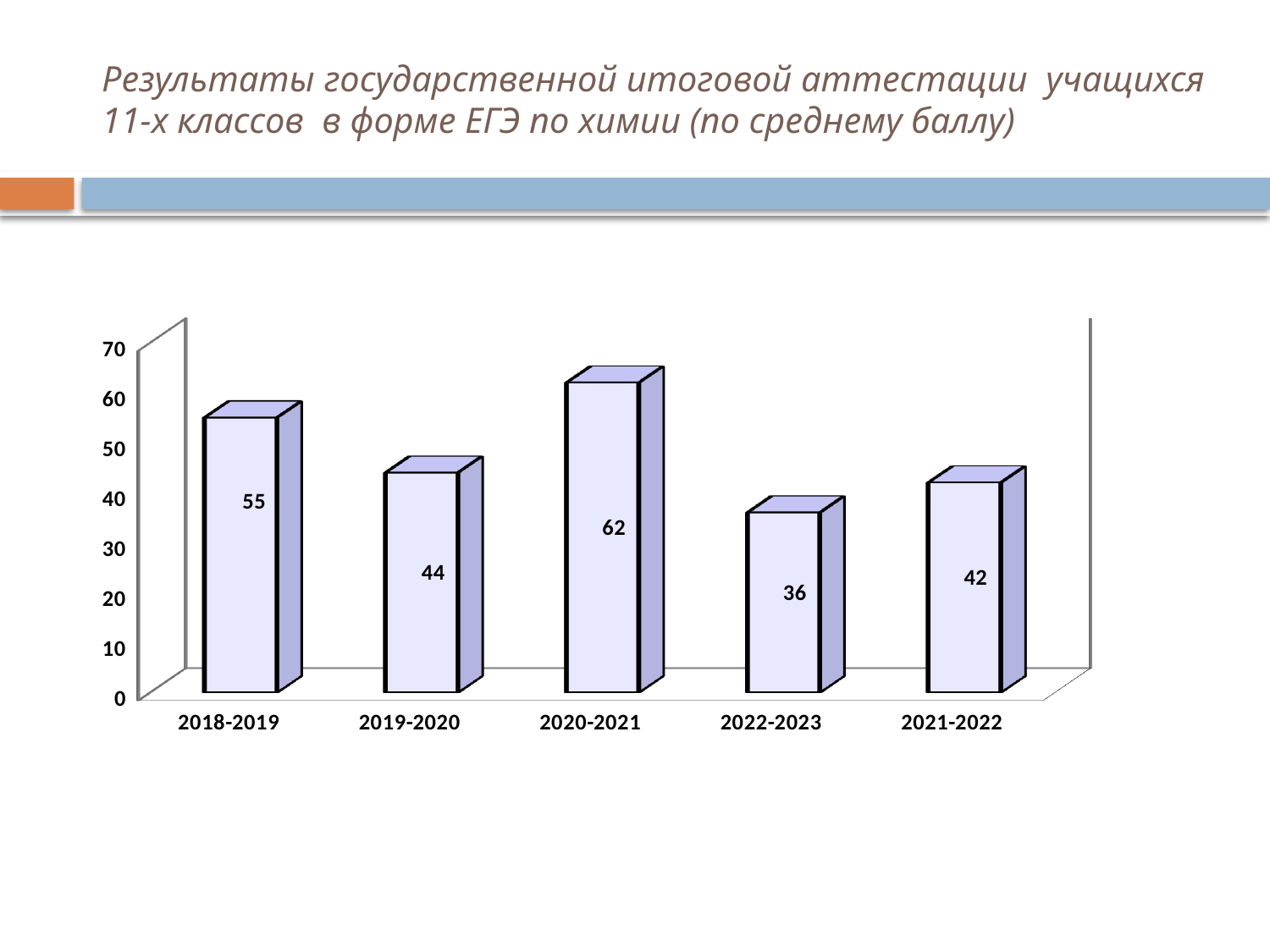
What is the difference between the values for 2020-2021 and 2022-2023? 26 What is the value for 2022-2023? 36 What is the value for 2020-2021? 62 Which is larger, the value for 2018-2019 or the value for 2019-2020? 2018-2019 How many categories are shown on the x axis? 5 What is the value for 2018-2019? 55 Which category has the highest value? 2020-2021 Which category has the lowest value? 2022-2023 What kind of chart is shown on the slide? bar chart Is the value for 2021-2022 greater or less than 50? less What is the value for 2021-2022? 42 What is the value for 2019-2020? 44